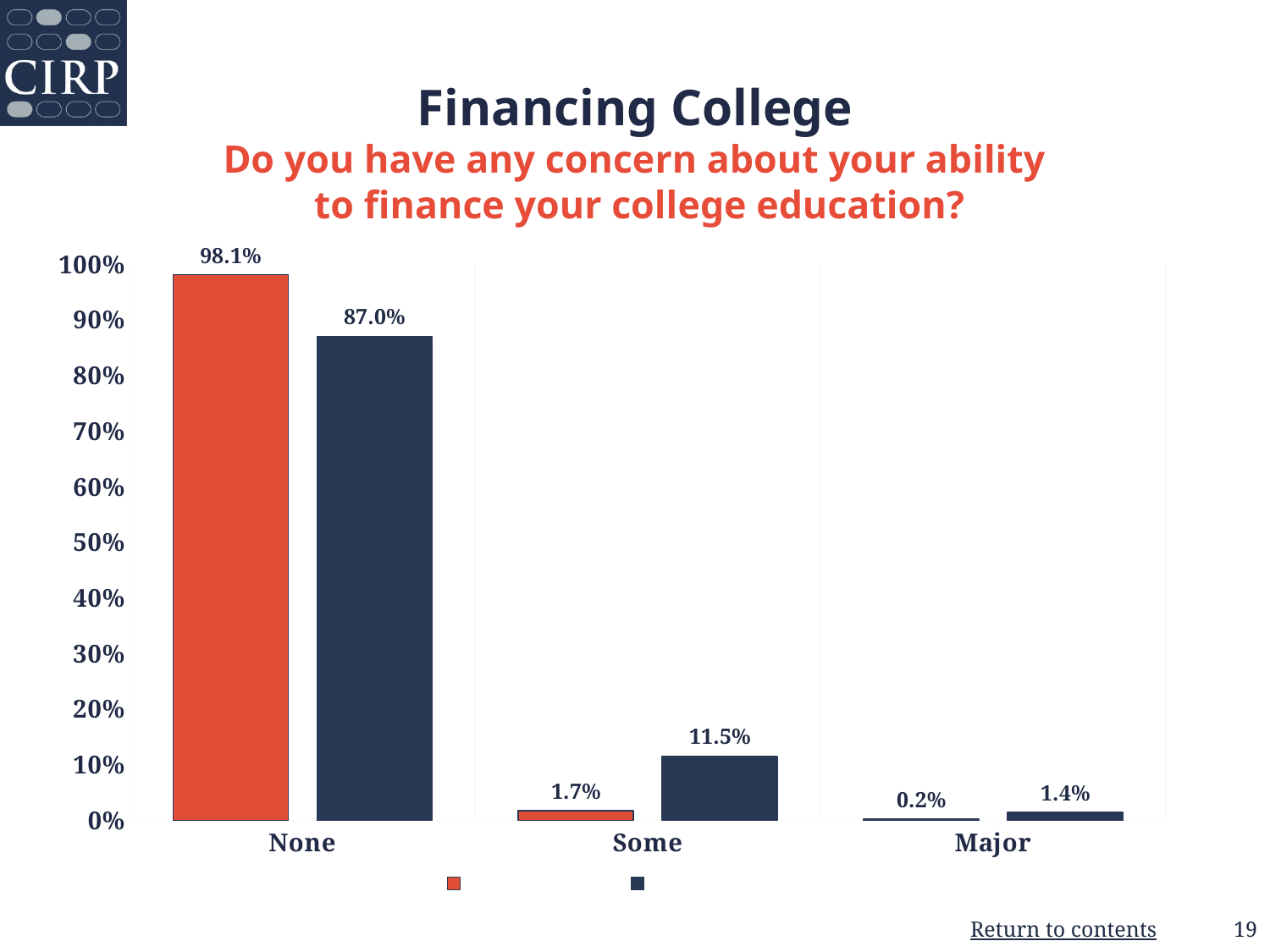
What type of chart is shown on the slide? bar chart What is the value of the orange bar for the "Major" category? 0.2% What is the value of the dark navy bar for the "Some" category? 11.5% Which category has the highest value for the orange series? None What is the value of the orange bar for the "None" category? 98.1% What is the difference between the orange and dark navy bars for the "None" category? 11.1% For the "Some" category, which bar is larger, the orange one or the dark navy one? dark navy What is the value of the dark navy bar for the "None" category? 87.0% How many series does the legend list? 2 Which category has the lowest value for the dark navy series? Major How many categories are shown on the x axis? 3 What is the value of the dark navy bar for the "Major" category? 1.4%